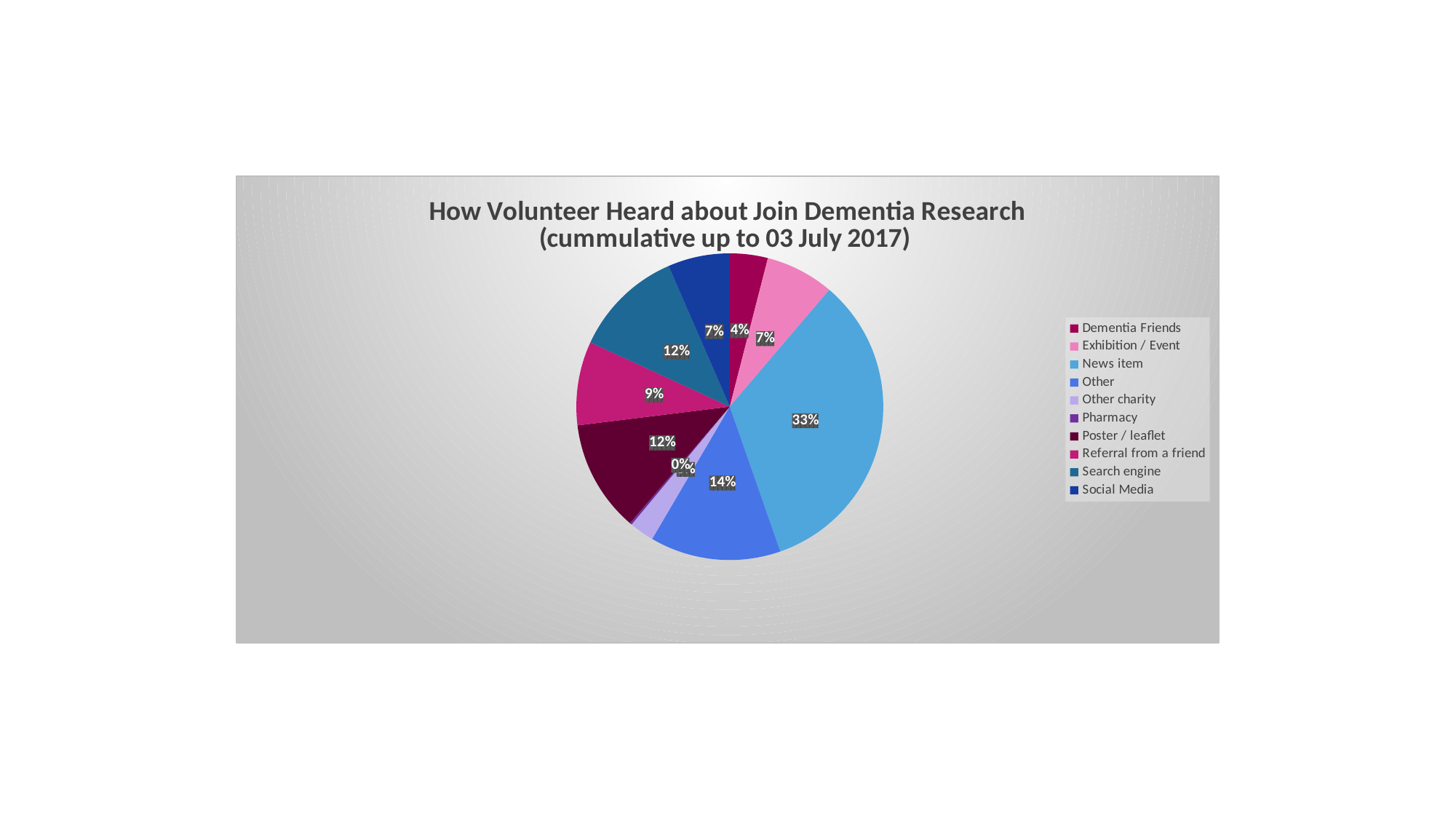
Which category has the largest slice of the pie? News item What percentage is shown for Exhibition / Event? 7% What kind of chart is shown on the slide? pie chart What percentage is shown for the Other slice? 14% What percentage is shown for Dementia Friends? 4% What is the title of the chart? How Volunteer Heard about Join Dementia Research (cummulative up to 03 July 2017) How many percentage points larger is the News item share than the Other share? 19% Which is larger, the share for Other or the share for Poster / leaflet? Other How many categories does the legend list? 10